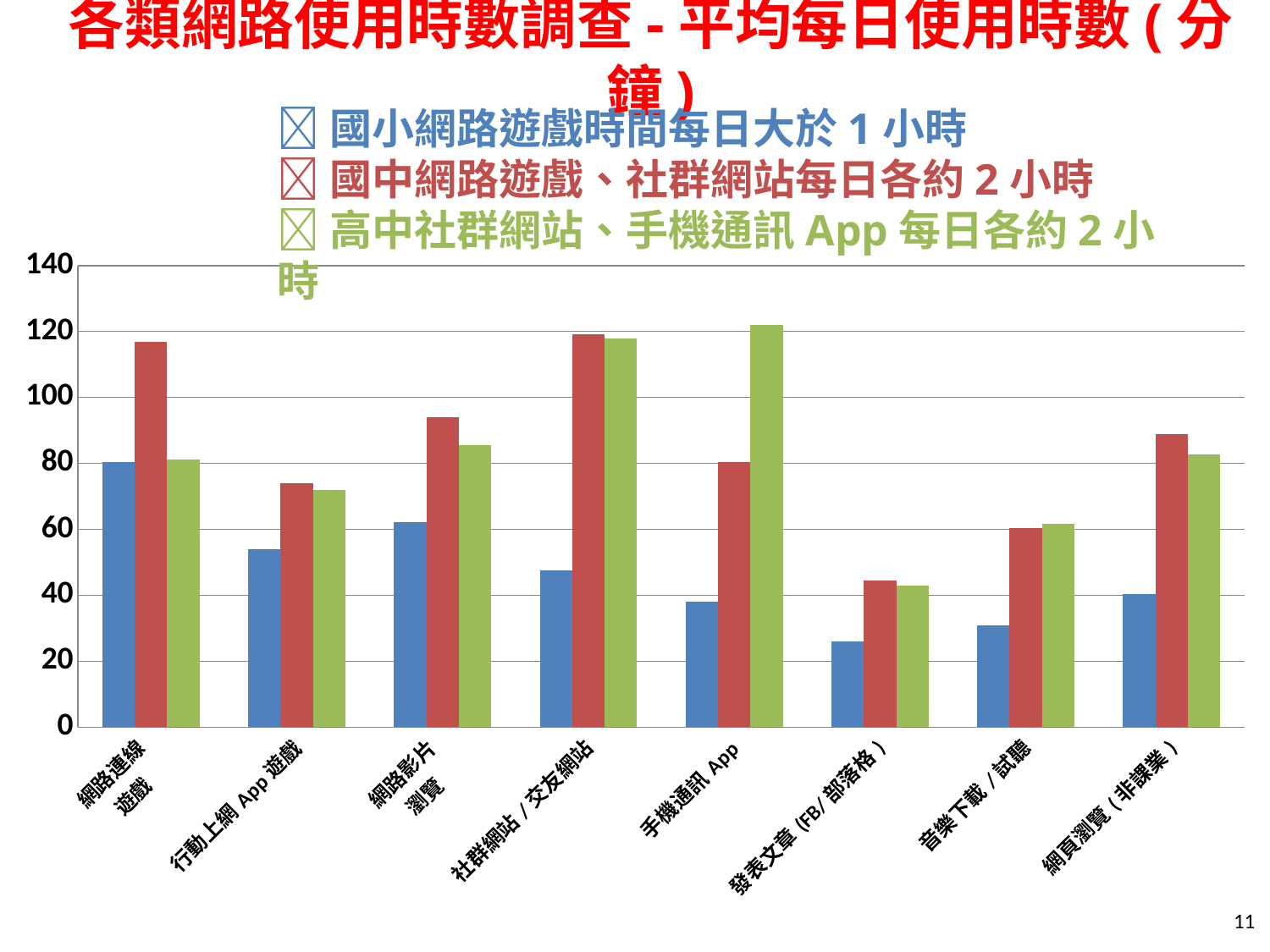
For 手機通訊 App, which bar is taller: the red bar or the green bar? green bar Is the value of the green bar for 手機通訊 App greater or less than 100? greater How many categories are shown along the x axis of the chart? 8 What kind of chart is shown on the slide? bar chart Is the value of the blue bar for 發表文章 (FB/ 部落格 ) greater or less than 40? less How many bars are plotted for each category in the chart? 3 Which category has the highest blue bar? 網路連線遊戲 Is the value of the red bar for 網路連線遊戲 greater or less than 100? greater Which category has the highest green bar? 手機通訊 App Which category has the lowest blue bar? 發表文章 (FB/ 部落格 ) What is the maximum value shown on the y axis of the chart? 140